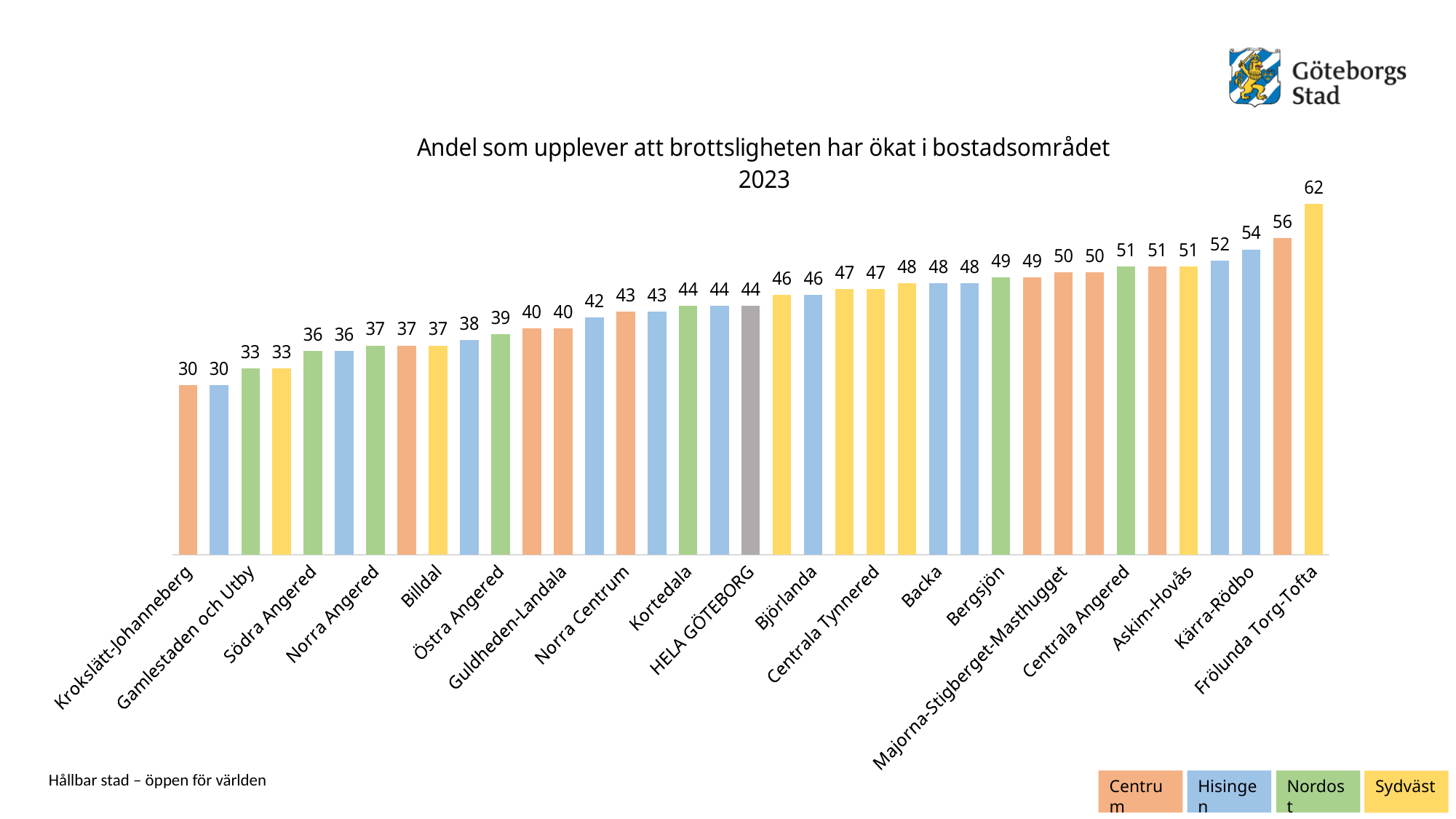
What kind of chart is shown on the slide? Bar chart What is the value for HELA GÖTEBORG? 44 What is the value for Billdal? 37 Which has the larger value, Backa or Björlanda? Backa What is the value for Bergsjön? 49 Do the values rise or fall from left to right along the x axis? Rise What is the value for Frölunda Torg-Tofta? 62 What is the value for Kärra-Rödbo? 54 Which labelled area has the highest value? Frölunda Torg-Tofta How many entries does the legend list? 4 What is the lowest value shown on the chart? 30 What is the difference between the values for Frölunda Torg-Tofta and HELA GÖTEBORG? 18